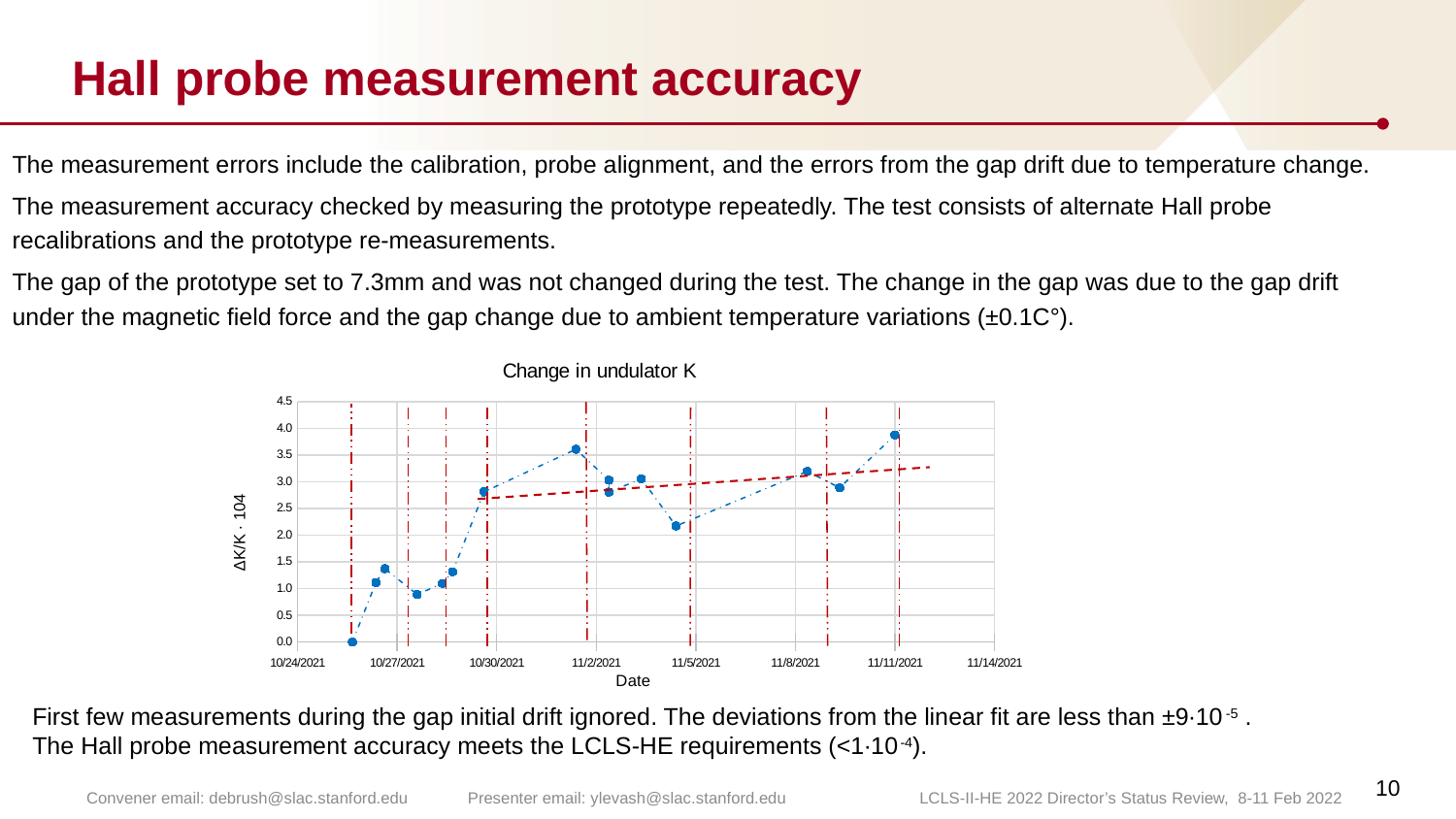
Do the plotted values generally rise or fall from 10/24/2021 to 11/11/2021? rise What is the label of the vertical axis of the chart? ΔK/K · 10^4 Which is larger, the plotted value at 11/11/2021 or at 11/8/2021? 11/11/2021 Is the first plotted point (just after 10/24/2021) greater or less than 0.5? less Is the plotted value at 11/11/2021 greater or less than 3.5? greater What is the lowest plotted value on the chart? 0.0 Is the plotted value at 11/8/2021 greater or less than 2.5? greater What is the title of the chart? Change in undulator K On which date does the plotted ΔK/K reach its highest value? 11/11/2021 What kind of chart is shown on the slide? line chart